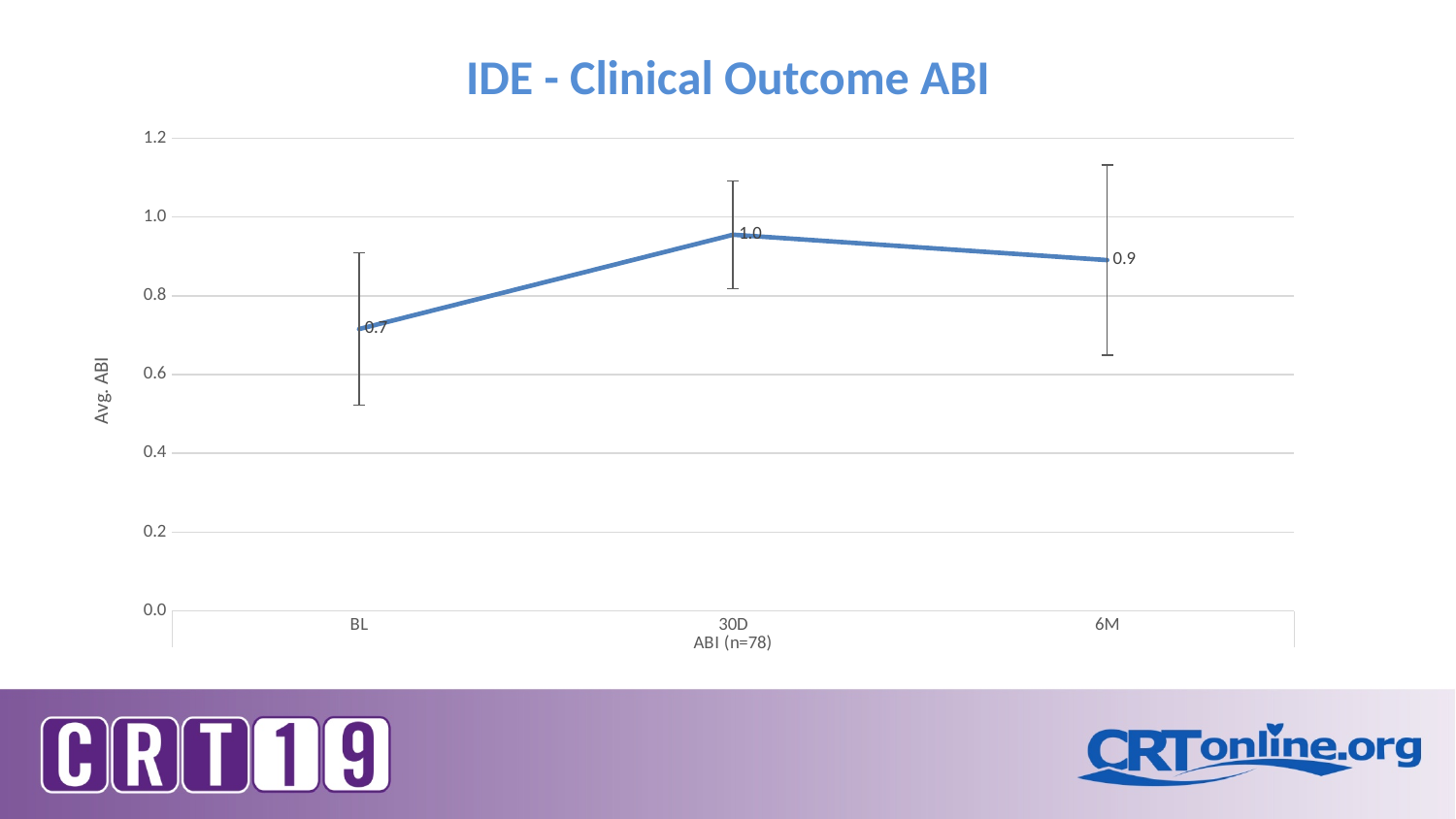
Does the average ABI rise or fall from BL to 30D? rise Which has a higher average ABI, 6M or BL? 6M What is the average ABI value at 6M? 0.9 How many time points are plotted on the chart? 3 What is the average ABI value at BL? 0.7 What is the average ABI value at 30D? 1.0 At which time point is the average ABI highest? 30D What kind of chart is shown on the slide? line chart What is the difference between the average ABI at 30D and at BL? 0.3 Is the value for BL greater or less than 0.8? less At which time point is the average ABI lowest? BL What is the title of the chart? IDE - Clinical Outcome ABI